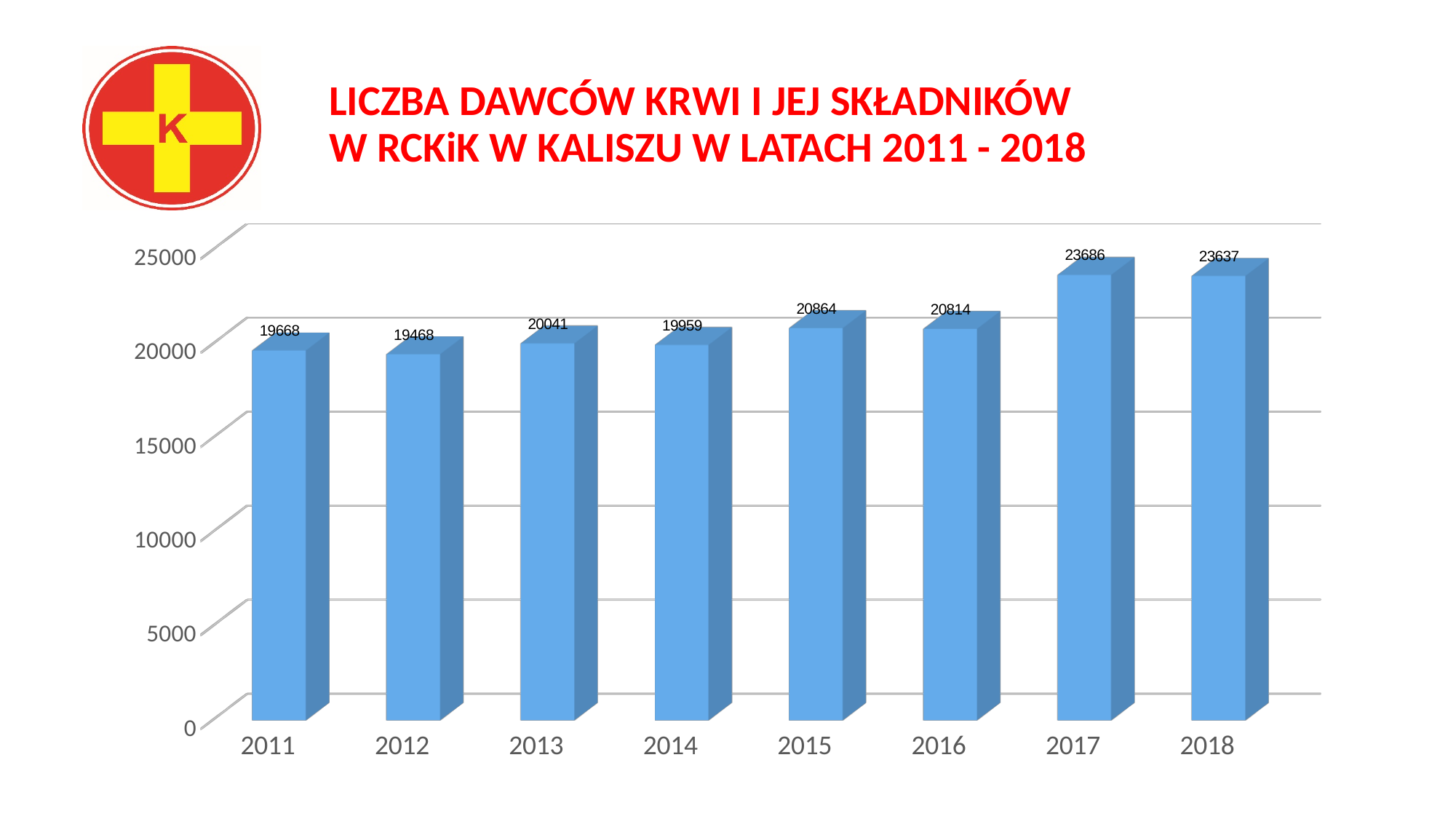
Which is larger, the value for 2015 or the value for 2014? 2015 How many years are shown on the x axis? 8 What is the value for 2015? 20864 What is the difference between the values for 2017 and 2016? 2872 What is the value for 2018? 23637 Which year has the lowest value? 2012 What is the value for 2011? 19668 Is the value for 2016 greater or less than 20000? greater What is the difference between the values for 2013 and 2012? 573 Which year has the highest value? 2017 What kind of chart is shown on the slide? bar chart What is the title of the chart? LICZBA DAWCÓW KRWI I JEJ SKŁADNIKÓW W RCKiK W KALISZU W LATACH 2011 - 2018